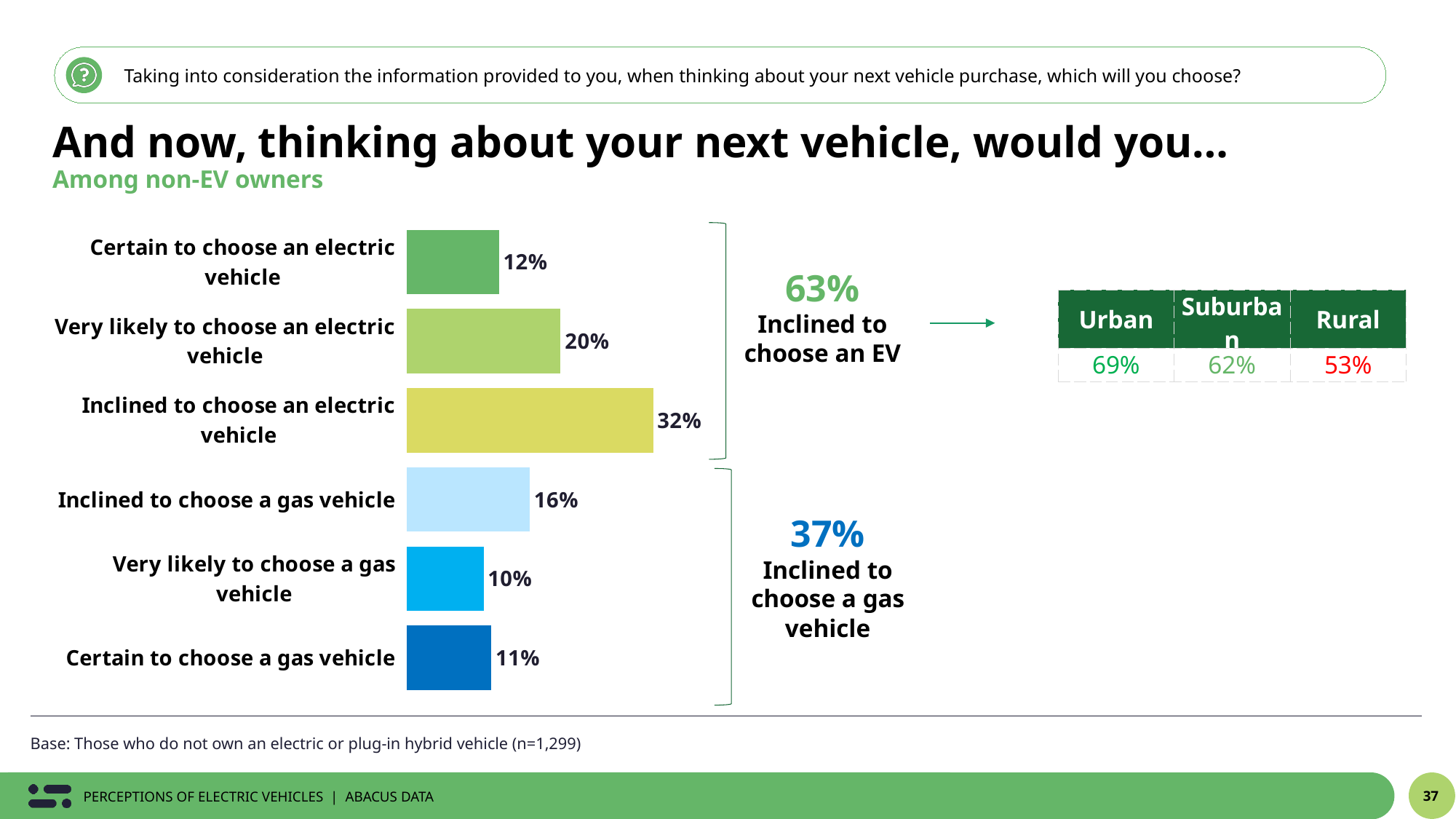
What percentage of non-EV owners are certain to choose an electric vehicle? 12% What kind of chart is shown on the slide? Bar chart What percentage of non-EV owners are very likely to choose a gas vehicle? 10% Which is larger: the value for 'Certain to choose a gas vehicle' or 'Certain to choose an electric vehicle'? Certain to choose an electric vehicle What is the difference between the value for 'Inclined to choose an electric vehicle' and 'Very likely to choose an electric vehicle'? 12% What is the combined percentage of non-EV owners inclined to choose an EV, as shown on the slide? 63% In the table on the right, what percentage of rural respondents are inclined to choose an EV? 53% In the table on the right, which group has the highest share inclined to choose an EV? Urban Which category has the highest value in the bar chart? Inclined to choose an electric vehicle How many categories are shown in the bar chart? 6 What percentage of non-EV owners are inclined to choose a gas vehicle? 16% Which category has the lowest value in the bar chart? Very likely to choose a gas vehicle